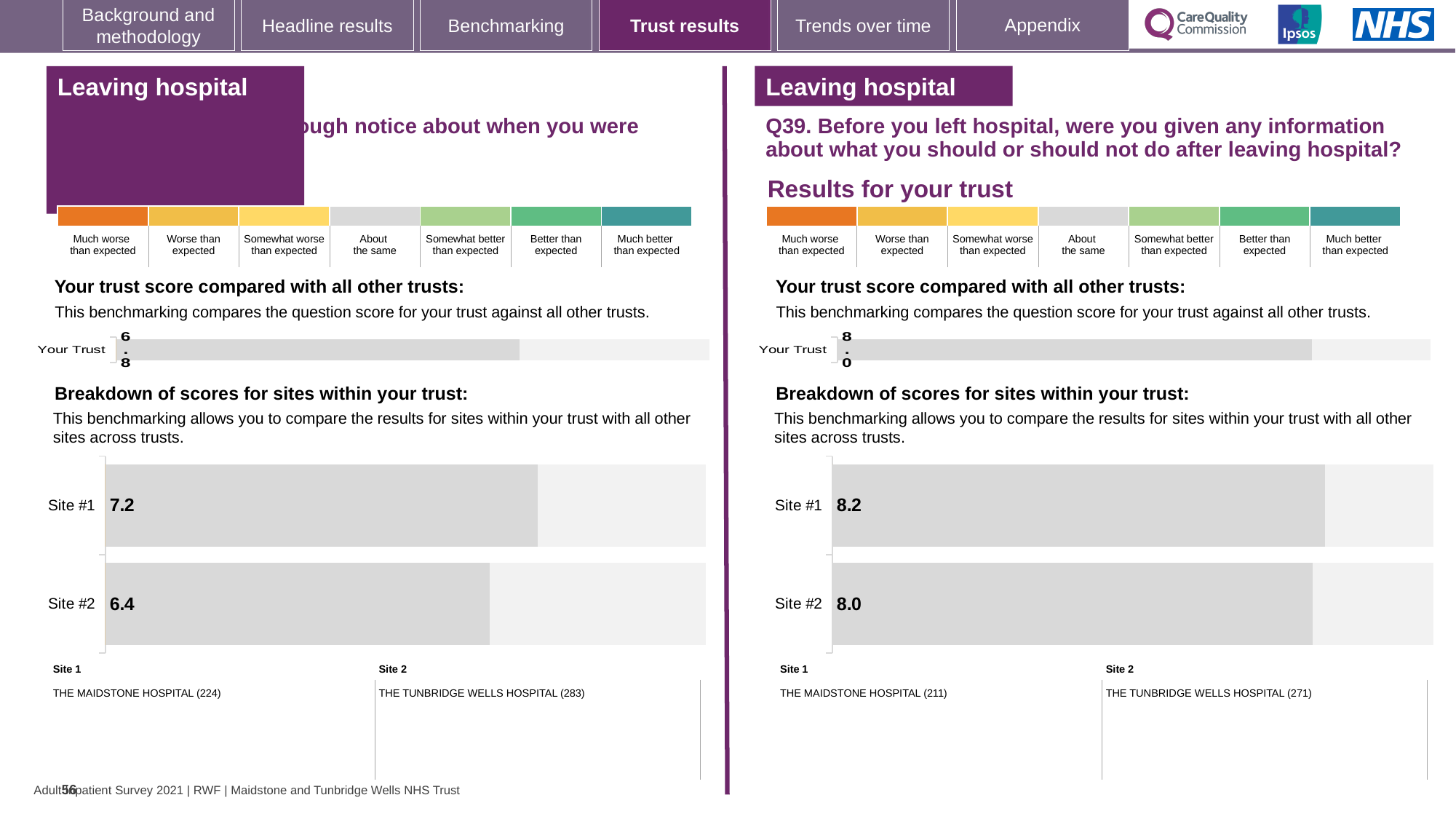
In the right-hand (Q39) 'Breakdown of scores for sites within your trust' chart, what is the score for Site #2? 8.0 How many sites are plotted in the left-hand 'Breakdown of scores for sites within your trust' chart? 2 In the left-hand site breakdown chart, which site has the highest score? Site #1 In the right-hand (Q39) site breakdown chart, what is the difference between the scores for Site #1 and Site #2? 0.2 In the right-hand (Q39) 'Breakdown of scores for sites within your trust' chart, what is the score for Site #1? 8.2 In the left-hand 'Breakdown of scores for sites within your trust' chart, what is the score for Site #2? 6.4 In the left-hand site breakdown chart, how much higher is the score for Site #1 than for Site #2? 0.8 In the left-hand 'Breakdown of scores for sites within your trust' chart, what is the score for Site #1? 7.2 What type of chart is used for the right-hand (Q39) 'Breakdown of scores for sites within your trust'? Bar chart In the right-hand (Q39) site breakdown chart, which site has the larger score, Site #1 or Site #2? Site #1 In the right-hand (Q39) 'Your trust score compared with all other trusts' chart, what is the score shown for Your Trust? 8.0 In the left-hand 'Your trust score compared with all other trusts' chart, what is the score shown for Your Trust? 6.8